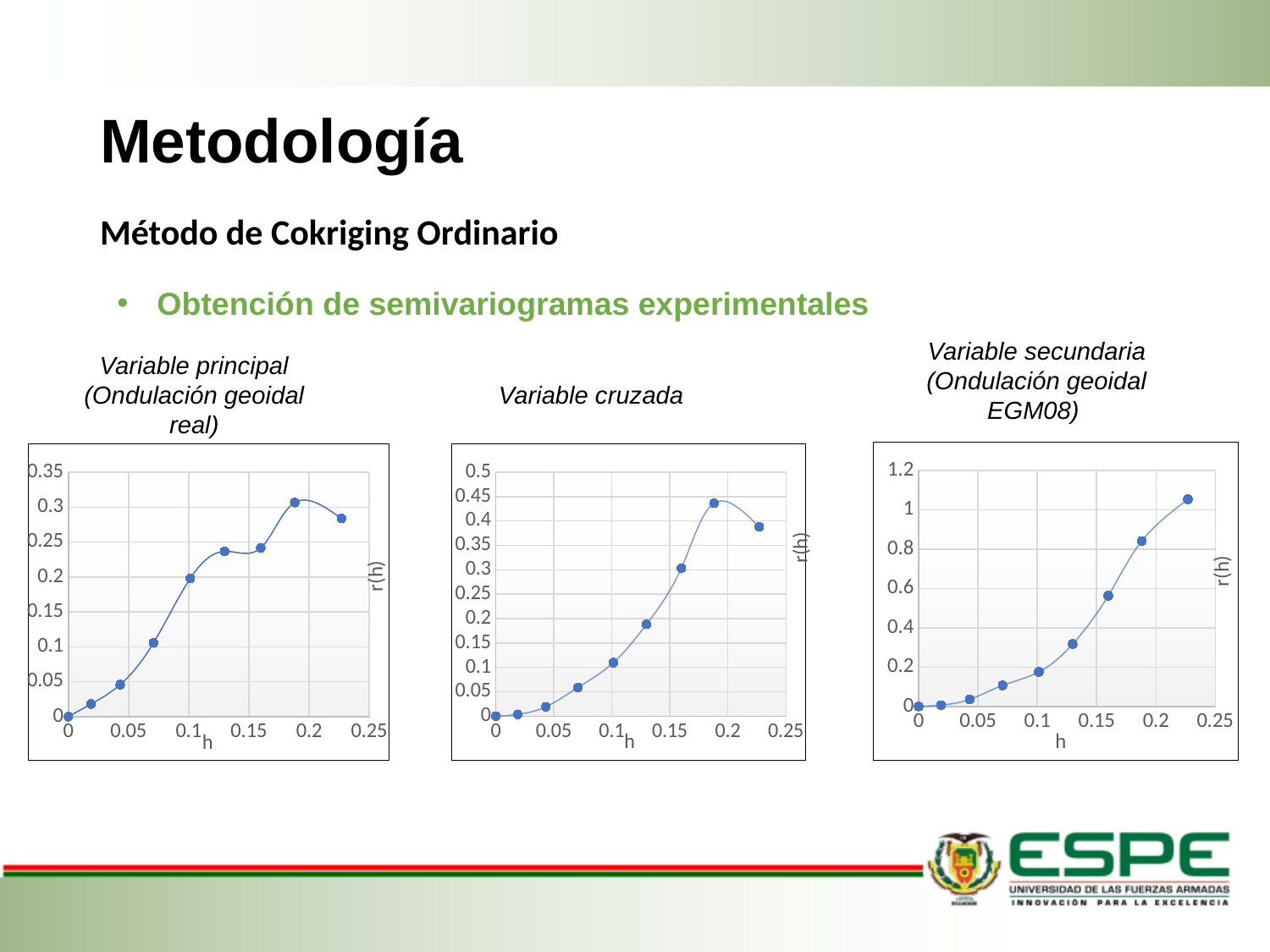
On the 'Variable cruzada' chart, is the highest plotted value of r(h) greater or less than 0.5? less What kind of chart is the 'Variable principal (Ondulación geoidal real)' chart? line chart On the 'Variable cruzada' chart, is the highest value of r(h) at the last point or at the second-to-last point? second-to-last point On the 'Variable secundaria (Ondulación geoidal EGM08)' chart, is the value of r(h) at the last point (h ≈ 0.225) greater or less than 1? greater What is the maximum value shown on the vertical axis of the 'Variable secundaria (Ondulación geoidal EGM08)' chart? 1.2 What is the value of r(h) at h = 0 on the 'Variable principal (Ondulación geoidal real)' chart? 0 How many data points are plotted on the 'Variable cruzada' chart? 9 On the 'Variable principal (Ondulación geoidal real)' chart, is the value of r(h) at the last point (h ≈ 0.225) greater or less than 0.3? less On the 'Variable secundaria (Ondulación geoidal EGM08)' chart, do the values of r(h) rise or fall as h increases? rise What label is shown on the horizontal axis of the 'Variable cruzada' chart? h